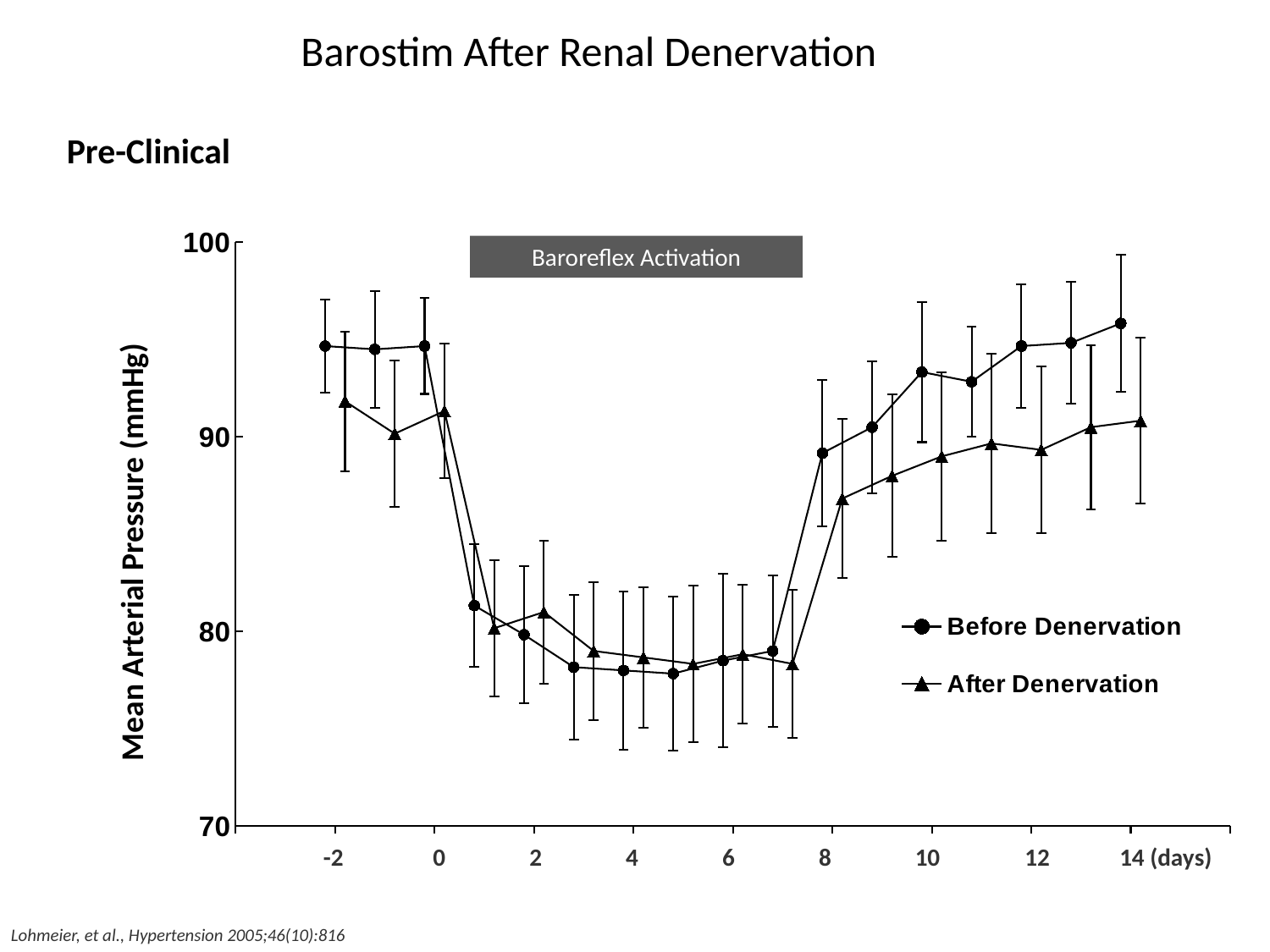
Is the Before Denervation value at day 14 greater or less than 90? greater Is the Before Denervation value at day 4 greater or less than 80? less Does the Before Denervation series rise or fall from day 8 to day 14? Rise At day 14, which series has the higher value, Before Denervation or After Denervation? Before Denervation What is the label on the y axis? Mean Arterial Pressure (mmHg) What are the two series named in the legend? Before Denervation and After Denervation What kind of chart is shown on the slide? Line chart Is the After Denervation value at day 8 greater or less than 90? less Does the Before Denervation series rise or fall from day 0 to day 1? Fall How many series does the legend list? 2